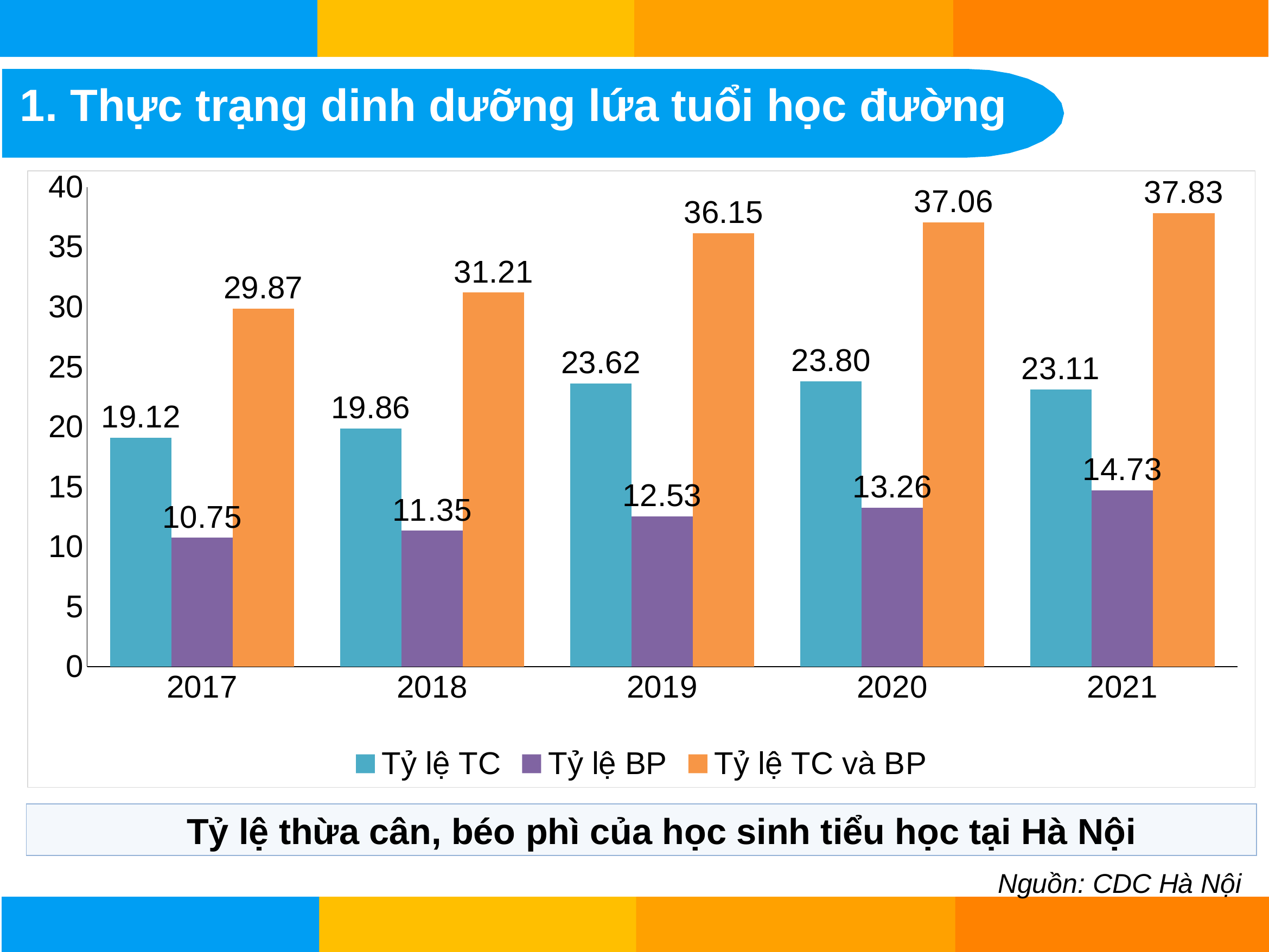
How many years are shown on the x axis? 5 What kind of chart is shown on the slide? Bar chart Does Tỷ lệ BP rise or fall from 2017 to 2021? Rise What is the value of Tỷ lệ TC in 2019? 23.62 In which year is Tỷ lệ BP lowest? 2017 In which year is Tỷ lệ TC và BP highest? 2021 What is the difference between Tỷ lệ TC và BP in 2021 and in 2017? 7.96 How many series does the legend list? 3 Is the value of Tỷ lệ TC và BP in 2019 greater or less than 35? greater What is the value of Tỷ lệ TC và BP in 2017? 29.87 What is the value of Tỷ lệ BP in 2021? 14.73 Which is larger: Tỷ lệ TC in 2020 or Tỷ lệ TC in 2021? Tỷ lệ TC in 2020